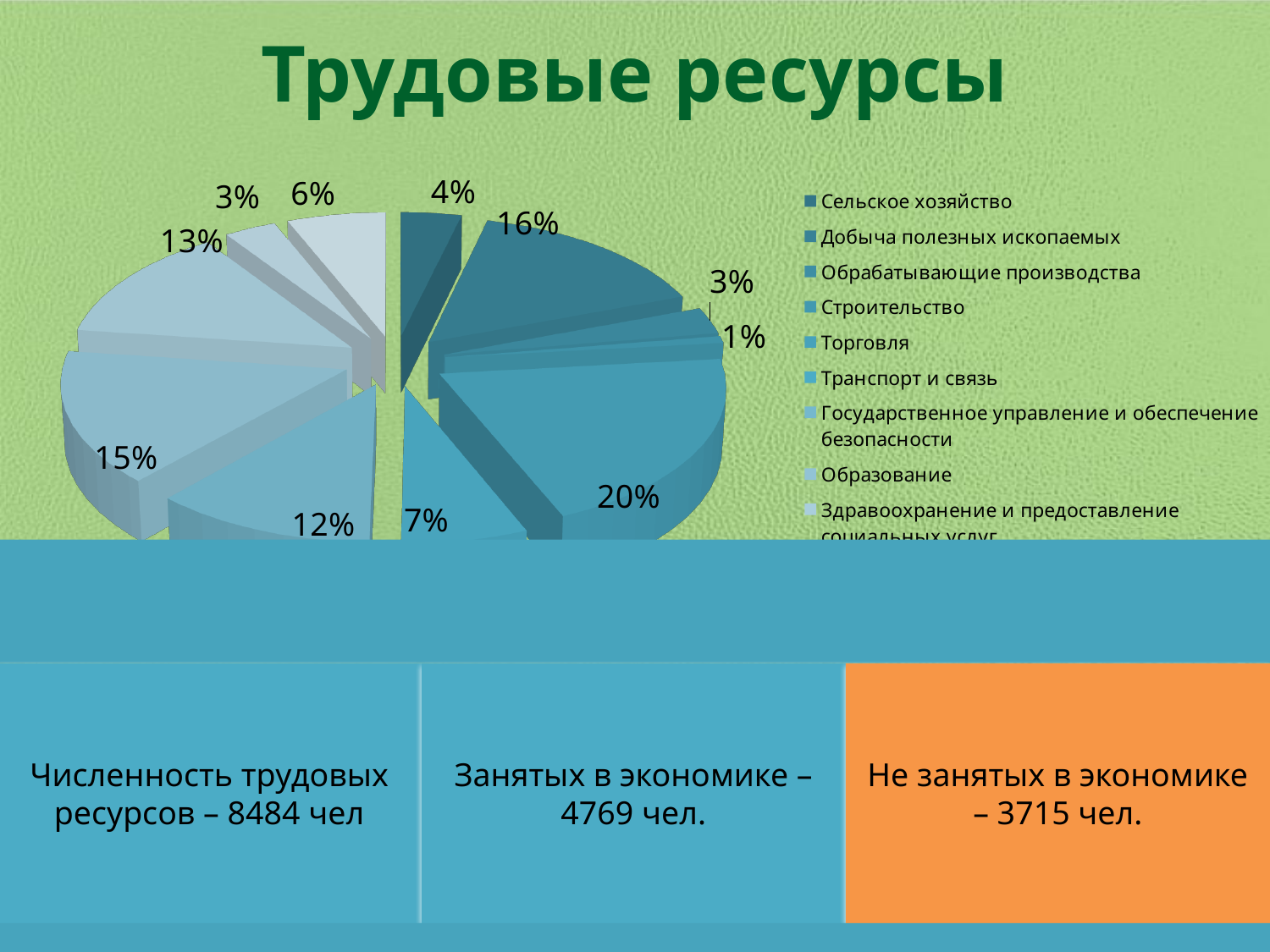
What is the largest percentage shown on the pie chart? 20% What is the difference between the largest slice (20%) and the 16% slice? 4 percentage points What kind of chart is shown on the slide? pie chart How many slices of the pie chart are labelled 3%? 2 What is the smallest percentage shown on the pie chart? 1% Which is larger, the 12% slice or the 7% slice? 12% What share of the pie does Сельское хозяйство have? 4% Which is larger, the 15% slice or the 13% slice? 15% What share of the pie does Добыча полезных ископаемых have? 16% How many slices does the pie chart have? 11 What is the title of the slide containing the pie chart? Трудовые ресурсы What is the first entry listed in the pie chart's legend? Сельское хозяйство